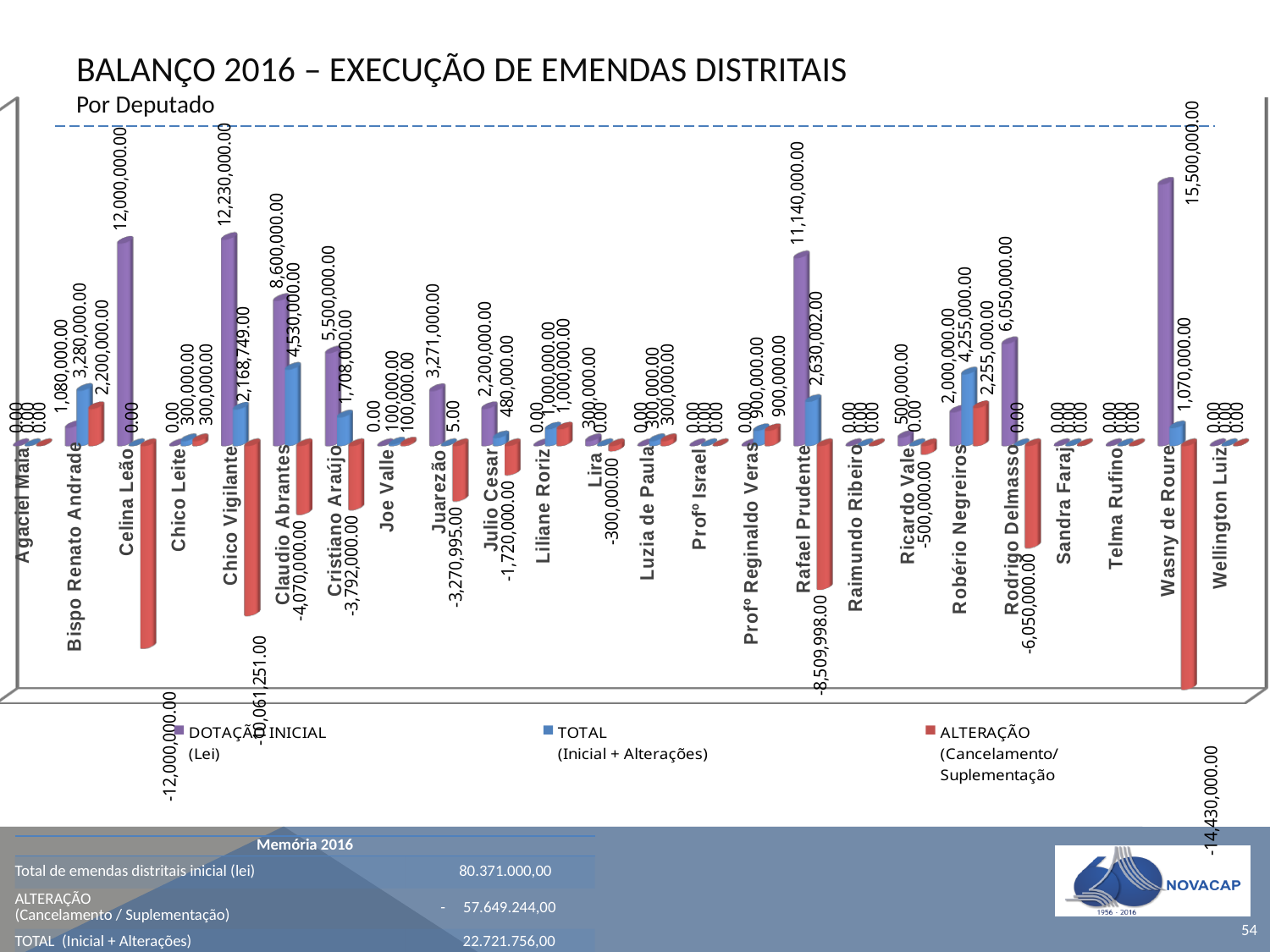
Which is larger, the TOTAL value for Bispo Renato Andrade or the TOTAL value for Rafael Prudente? Bispo Renato Andrade How many deputies (categories) are shown on the x axis? 24 What is the DOTAÇÃO INICIAL (Lei) value for Wasny de Roure? 15,500,000.00 What is the title of the chart? BALANÇO 2016 – EXECUÇÃO DE EMENDAS DISTRITAIS What is the ALTERAÇÃO value for Rafael Prudente? -8,509,998.00 What is the TOTAL (Inicial + Alterações) value for Claudio Abrantes? 4,530,000.00 How many series does the legend list? 3 Which deputy has the highest DOTAÇÃO INICIAL (Lei) value? Wasny de Roure What is the difference between the DOTAÇÃO INICIAL values of Chico Vigilante and Celina Leão? 230,000.00 What kind of chart is shown on the slide? bar chart Which deputy has the lowest (most negative) ALTERAÇÃO value? Wasny de Roure What is the TOTAL (Inicial + Alterações) value for Juarezão? 5.00